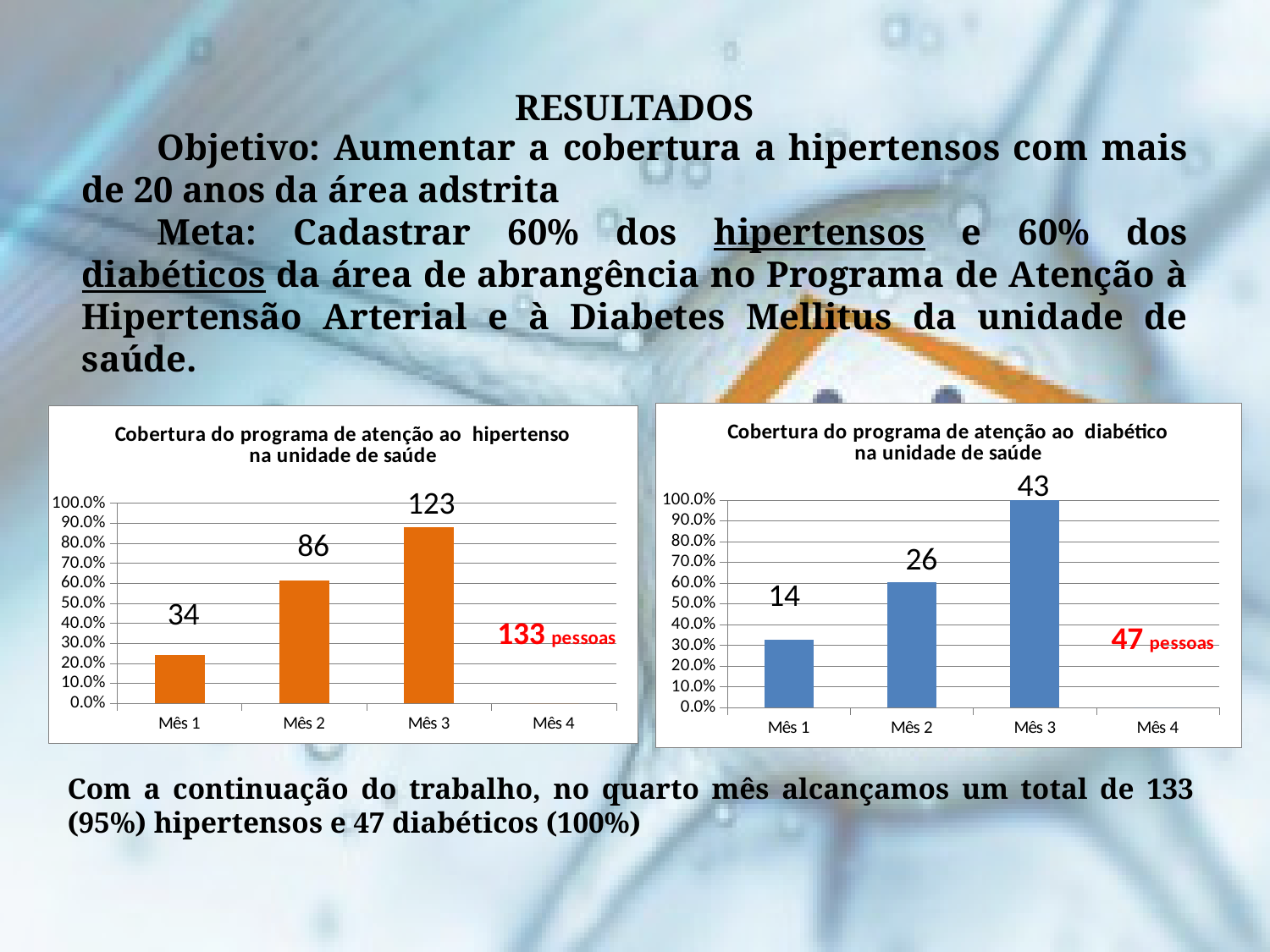
In the chart titled 'Cobertura do programa de atenção ao hipertenso na unidade de saúde', what is the data label for Mês 3? 123 In the left chart (hipertenso), is the bar for Mês 1 greater or less than 30.0%? less In the right chart (diabético), which of the plotted months has the shortest bar? Mês 1 In the chart titled 'Cobertura do programa de atenção ao hipertenso na unidade de saúde', what is the data label for Mês 2? 86 In the left chart (hipertenso), is the bar for Mês 3 greater or less than 80.0%? greater In the chart titled 'Cobertura do programa de atenção ao diabético na unidade de saúde', what is the data label for Mês 3? 43 In the chart titled 'Cobertura do programa de atenção ao diabético na unidade de saúde', what is the data label for Mês 1? 14 What type of chart is the left chart (hipertenso)? Bar chart How many month categories are shown on the x axis of the right chart (diabético)? 4 In the left chart (hipertenso), what is the difference between the data labels for Mês 3 and Mês 2? 37 In the right chart (diabético), what is the difference between the data labels for Mês 3 and Mês 1? 29 In the left chart (hipertenso), which month has the tallest bar? Mês 3